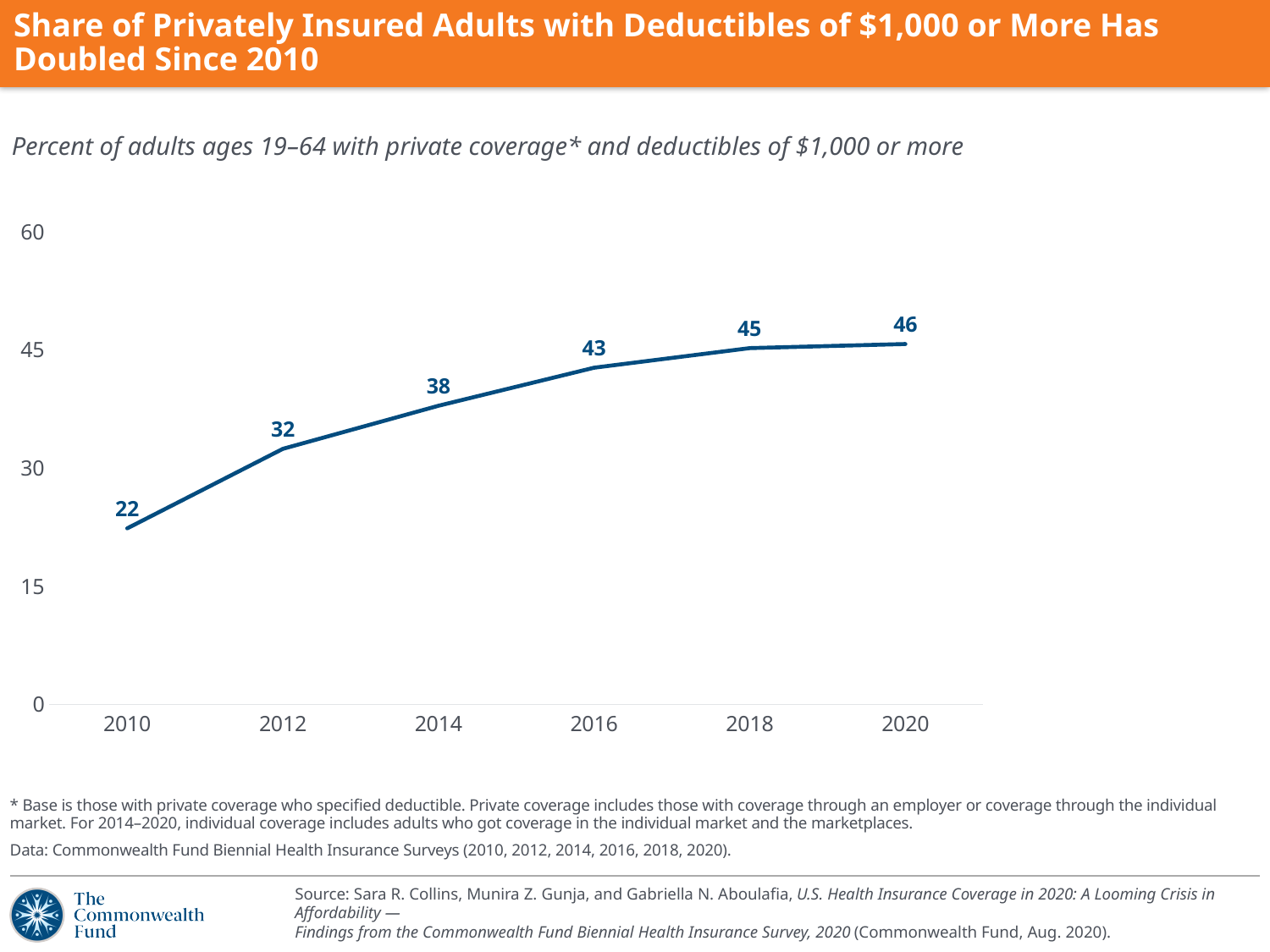
What kind of chart is shown on the slide? line chart Do the values rise or fall from 2010 to 2020? rise Is the value for 2018 greater or less than 30? greater What is the difference between the values for 2016 and 2012? 11 What is the difference between the values for 2020 and 2010? 24 Which year has the lowest value? 2010 How many years are plotted on the chart? 6 What is the value for 2020? 46 Which year has the highest value? 2020 What is the value for 2010? 22 Which is larger, the value for 2012 or the value for 2016? 2016 What is the value for 2014? 38